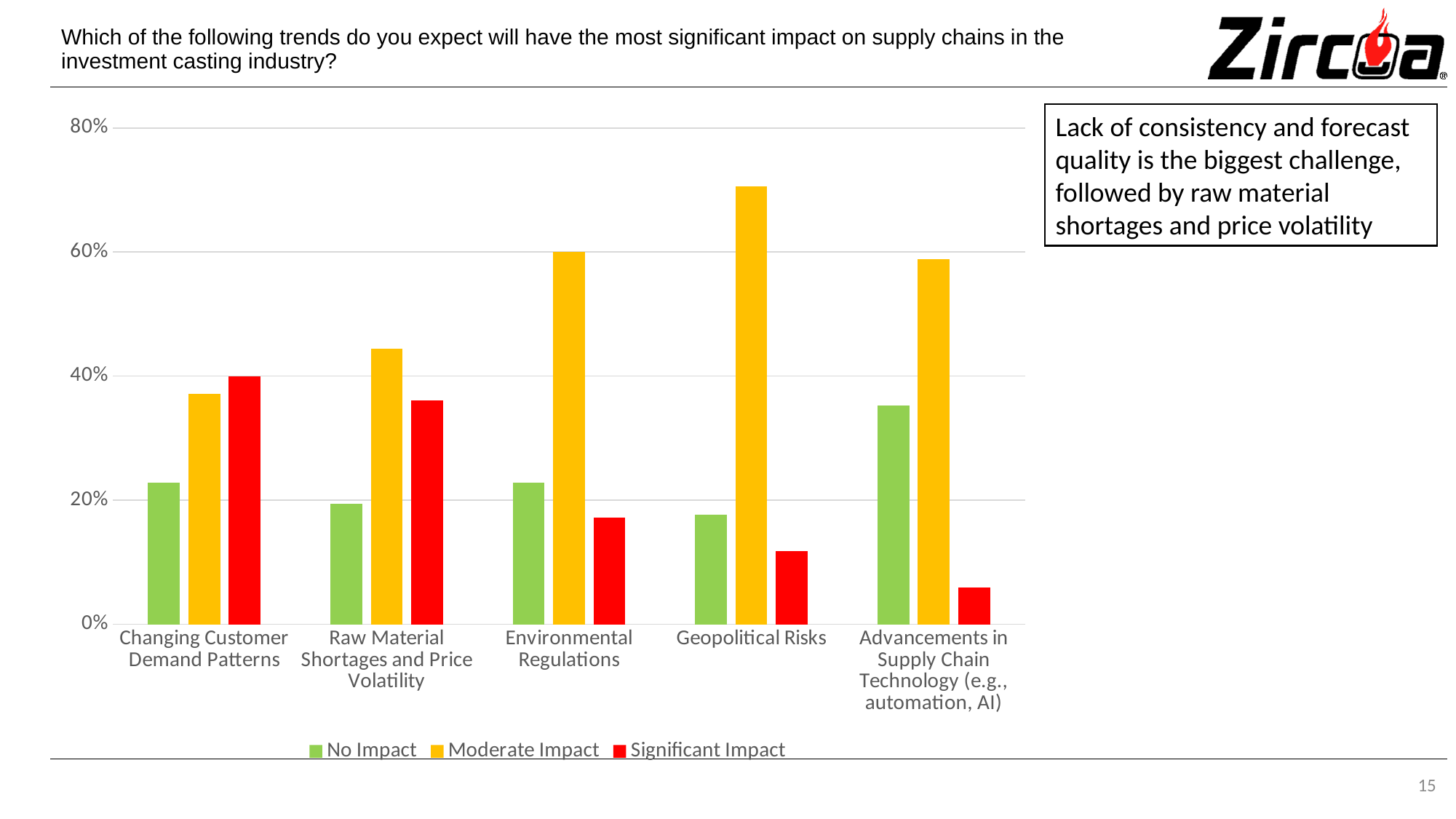
How many categories are shown on the x axis? 5 How many series does the legend list? 3 Which category has the lowest Significant Impact value? Advancements in Supply Chain Technology (e.g., automation, AI) Is the Moderate Impact value for Geopolitical Risks greater or less than 60%? greater Which category has the highest Moderate Impact value? Geopolitical Risks Which category has the highest No Impact value? Advancements in Supply Chain Technology (e.g., automation, AI) What kind of chart is shown on the slide? bar chart Is the No Impact value for Advancements in Supply Chain Technology greater or less than 20%? greater Which category has the highest Significant Impact value? Changing Customer Demand Patterns Is the Significant Impact value for Geopolitical Risks greater or less than 20%? less Do the Significant Impact values rise or fall moving left to right along the x axis? fall For Raw Material Shortages and Price Volatility, which is larger: the Moderate Impact value or the Significant Impact value? Moderate Impact